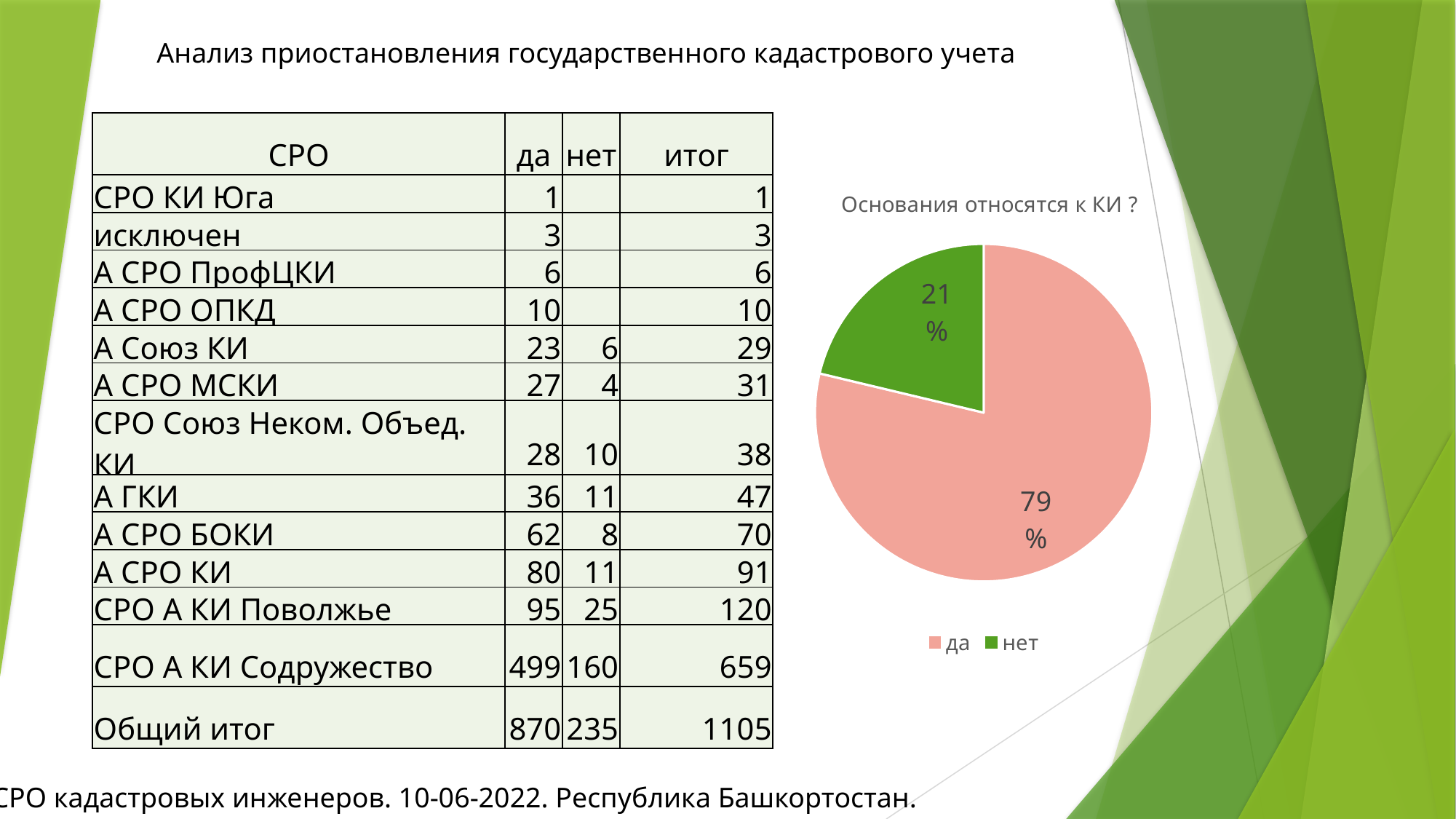
Which slice of the pie chart is the smallest? нет What colour is the "нет" slice in the pie chart? green What share of the pie chart does the "да" slice represent? 79% How many slices does the pie chart have? 2 Which is larger in the pie chart, the "да" slice or the "нет" slice? да How many entries does the pie chart legend list? 2 What is the difference in percentage points between the "да" and "нет" slices of the pie chart? 58% Which slice of the pie chart is the largest? да What type of chart is shown on the slide? pie chart What is the title of the pie chart? Основания относятся к КИ ? What share of the pie chart does the "нет" slice represent? 21%